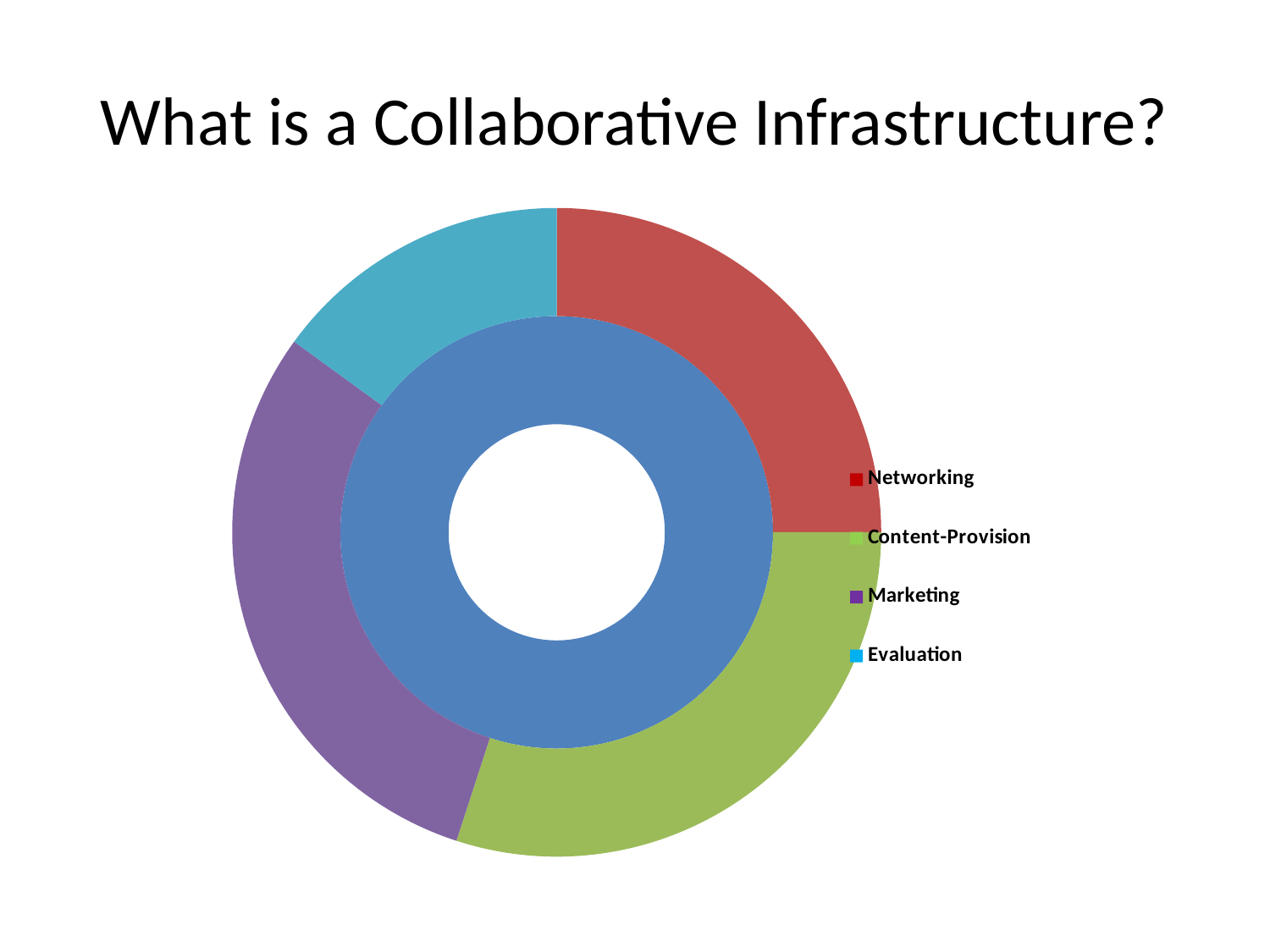
What kind of chart is shown on the slide? doughnut chart Which segment is larger in the outer ring, Content-Provision or Evaluation? Content-Provision How many categories does the legend of the chart list? 4 What is the title of the slide containing the chart? What is a Collaborative Infrastructure? What colour represents Networking in the chart? red Which segment is larger in the outer ring, Marketing or Evaluation? Marketing Which segment is larger in the outer ring, Networking or Evaluation? Networking Which category has the smallest segment in the outer ring of the chart? Evaluation